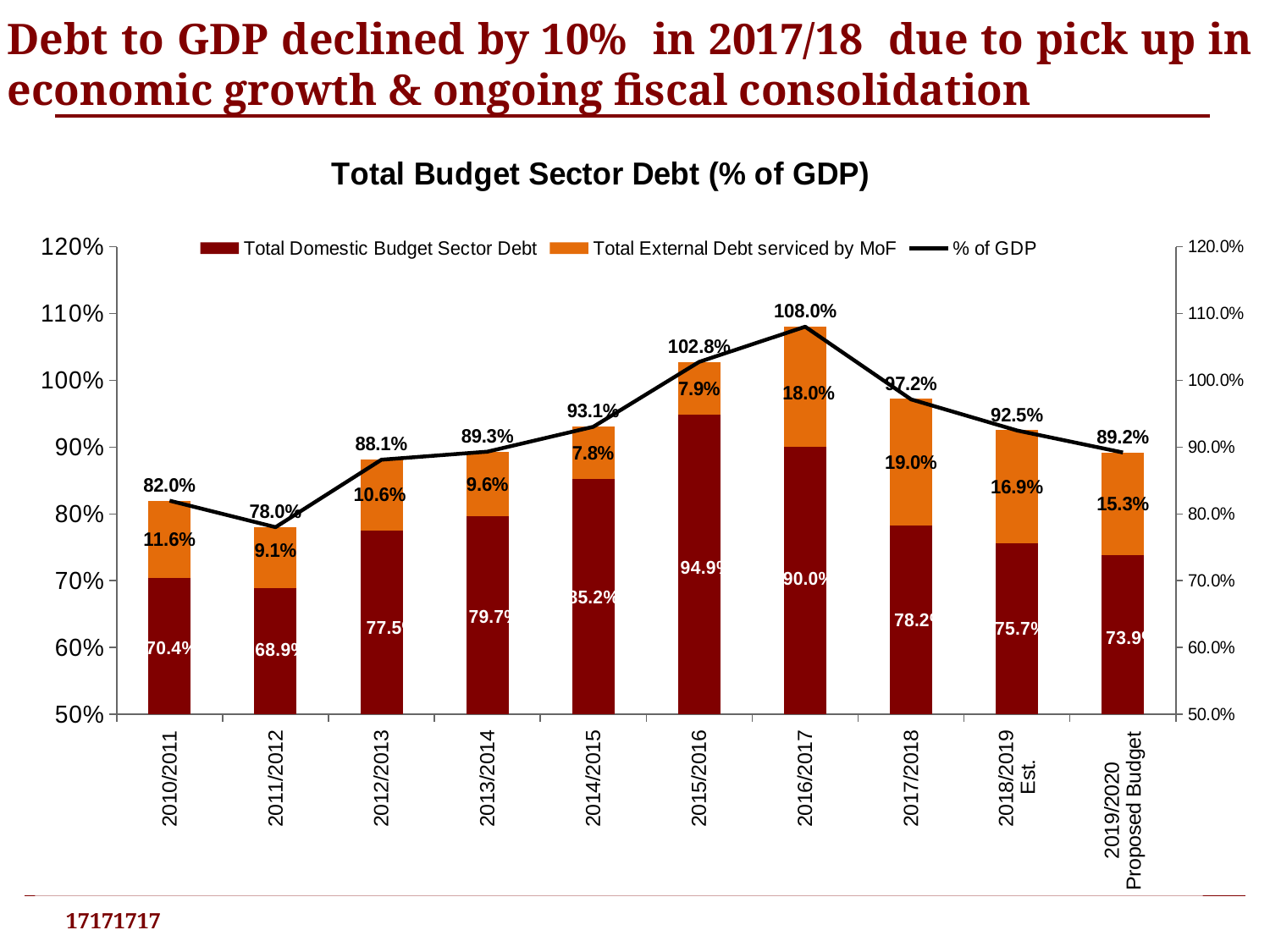
What kind of chart is this? Stacked bar chart with a line What is the Total Domestic Budget Sector Debt value for 2015/2016? 94.9% Which year has the highest % of GDP value? 2016/2017 What is the % of GDP value for 2019/2020 Proposed Budget? 89.2% Which is larger, the Total External Debt serviced by MoF value for 2010/2011 or for 2014/2015? 2010/2011 What is the title of the chart? Total Budget Sector Debt (% of GDP) What is the Total External Debt serviced by MoF value for 2017/2018? 19.0% How many series does the legend list? 3 Which year has the lowest % of GDP value? 2011/2012 How many years are shown on the x axis? 10 What is the % of GDP value for 2016/2017? 108.0% What is the difference between the % of GDP values for 2016/2017 and 2017/2018? 10.8%